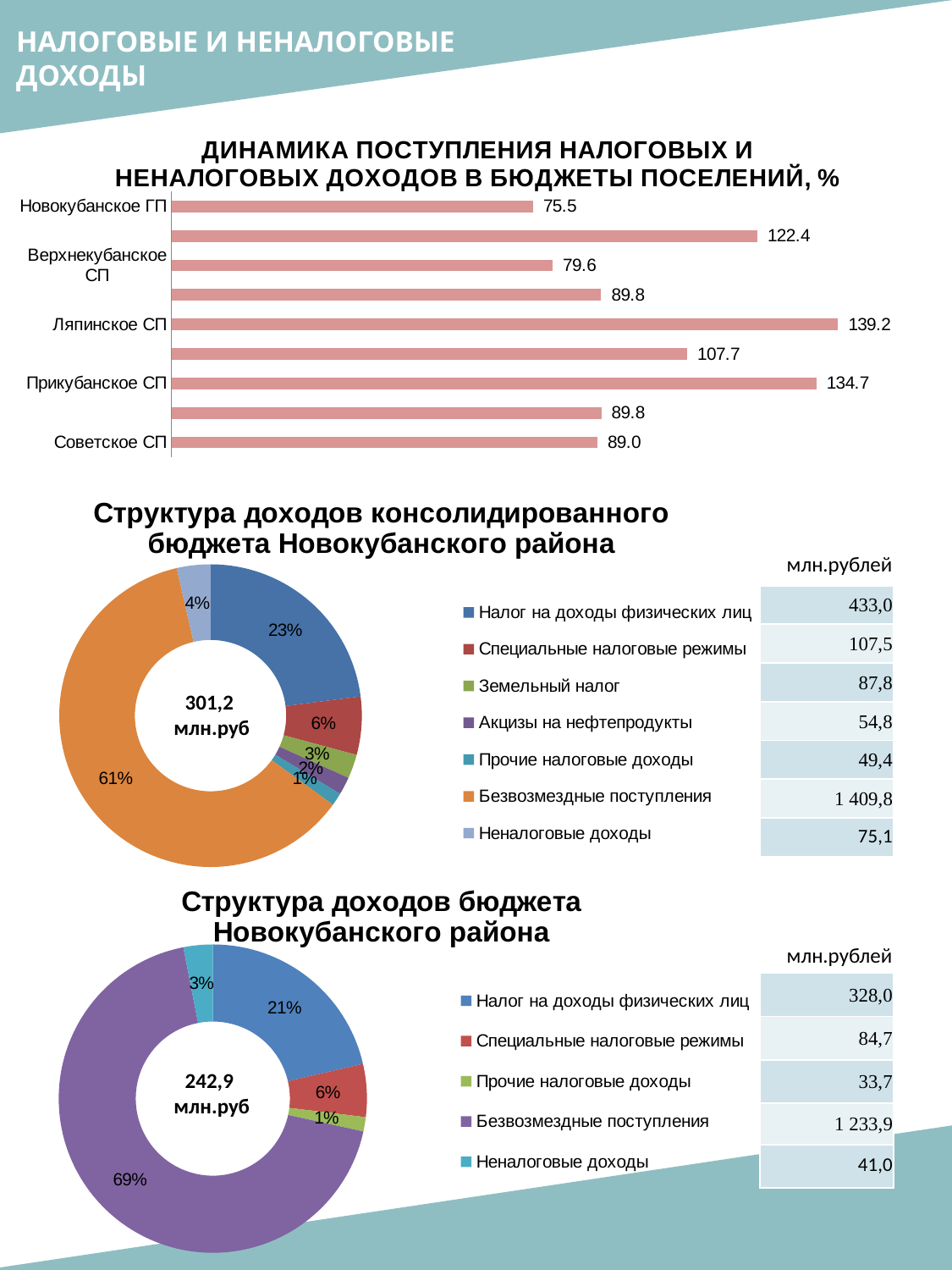
In the bar chart 'Динамика поступления налоговых и неналоговых доходов в бюджеты поселений, %', which labelled settlement has the highest value? Ляпинское СП What type of chart is 'Структура доходов консолидированного бюджета Новокубанского района'? Doughnut (pie) chart In the chart 'Структура доходов бюджета Новокубанского района', what share does Налог на доходы физических лиц have? 21% How many bars are plotted in the bar chart 'Динамика поступления налоговых и неналоговых доходов в бюджеты поселений, %'? 9 In the bar chart 'Динамика поступления налоговых и неналоговых доходов в бюджеты поселений, %', what is the value for Новокубанское ГП? 75.5 In the bar chart 'Динамика поступления налоговых и неналоговых доходов в бюджеты поселений, %', what is the difference between the values for Прикубанское СП and Советское СП? 45.7 In the bar chart 'Динамика поступления налоговых и неналоговых доходов в бюджеты поселений, %', what is the value for Ляпинское СП? 139.2 In the chart 'Структура доходов бюджета Новокубанского района', what value in млн.рублей is shown for Безвозмездные поступления? 1 233,9 In the chart 'Структура доходов консолидированного бюджета Новокубанского района', what share does Безвозмездные поступления have? 61% In the bar chart 'Динамика поступления налоговых и неналоговых доходов в бюджеты поселений, %', which labelled settlement has the lowest value? Новокубанское ГП How many categories does the legend of the chart 'Структура доходов консолидированного бюджета Новокубанского района' list? 7 In the bar chart 'Динамика поступления налоговых и неналоговых доходов в бюджеты поселений, %', which is larger: the value for Верхнекубанское СП or for Советское СП? Советское СП